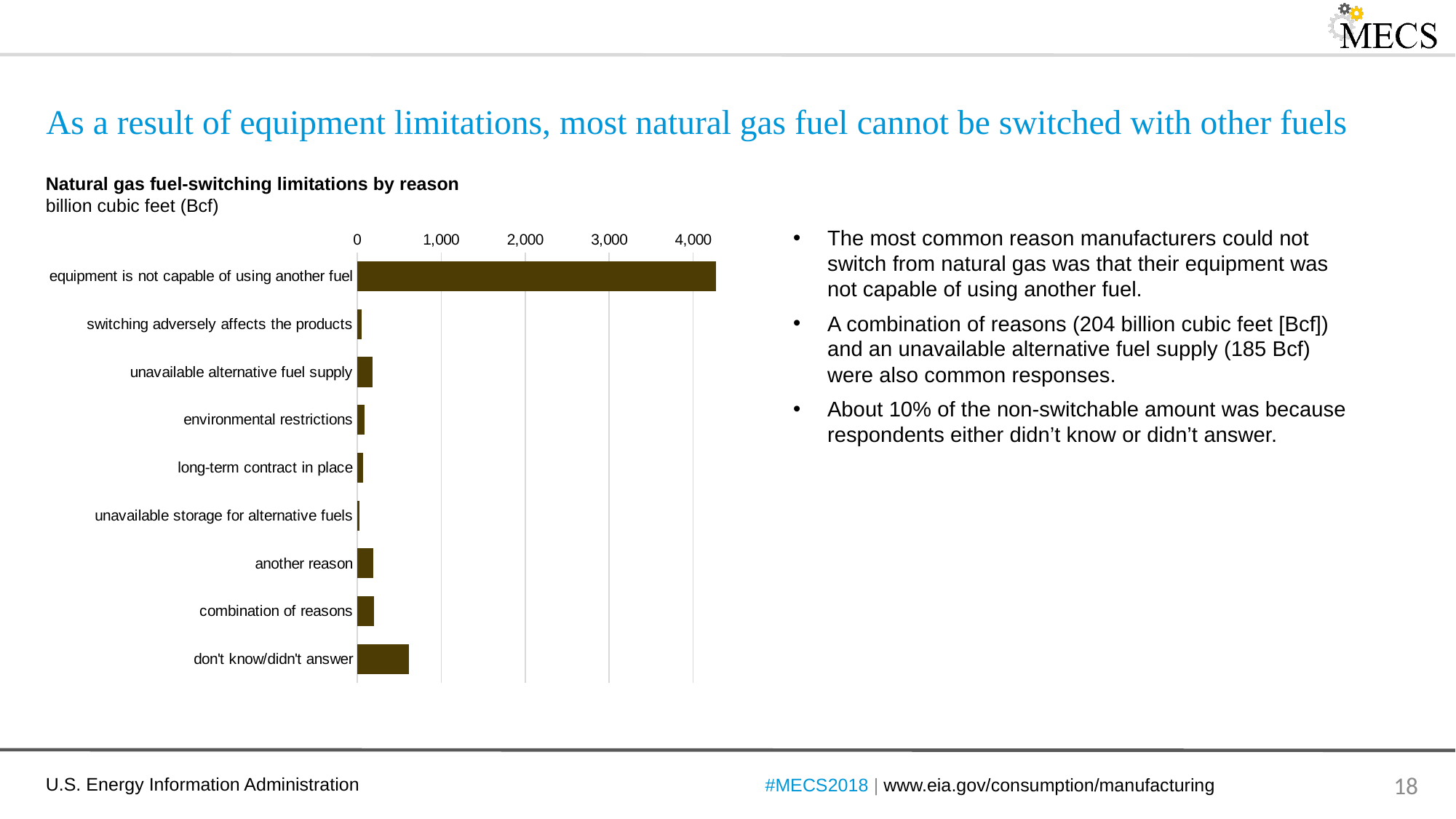
Which reason has the highest value in the chart? equipment is not capable of using another fuel Is the value for 'combination of reasons' greater or less than 1,000? less Which is larger: the value for 'unavailable alternative fuel supply' or the value for 'unavailable storage for alternative fuels'? unavailable alternative fuel supply Which is larger: the value for 'don't know/didn't answer' or the value for 'combination of reasons'? don't know/didn't answer Which is larger: the value for 'equipment is not capable of using another fuel' or the value for 'another reason'? equipment is not capable of using another fuel How many reasons (categories) are plotted in the chart? 9 What is the title of the chart? Natural gas fuel-switching limitations by reason Is the value for 'equipment is not capable of using another fuel' greater or less than 4,000? greater Which reason has the lowest value in the chart? unavailable storage for alternative fuels What kind of chart is shown on the slide? bar chart What unit are the chart values measured in? billion cubic feet (Bcf) Is the value for 'don't know/didn't answer' greater or less than 1,000? less